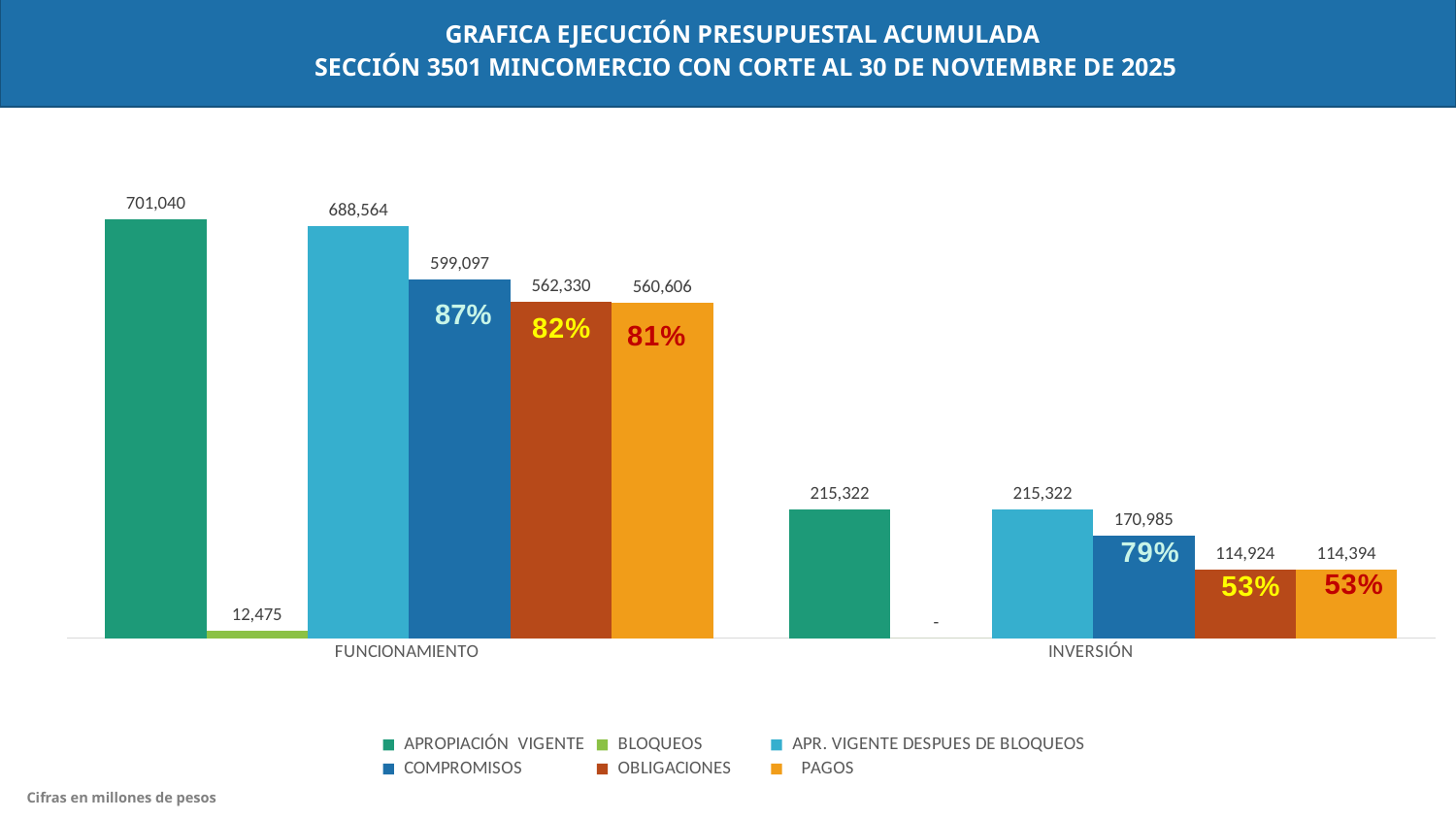
Which series has the highest value for FUNCIONAMIENTO? APROPIACIÓN VIGENTE What percentage is shown on the OBLIGACIONES bar for INVERSIÓN? 53% What is the difference between APROPIACIÓN VIGENTE and APR. VIGENTE DESPUES DE BLOQUEOS for FUNCIONAMIENTO? 12,476 What is the value of COMPROMISOS for INVERSIÓN? 170,985 Which series has the lowest value for FUNCIONAMIENTO? BLOQUEOS Which is larger for INVERSIÓN: OBLIGACIONES or PAGOS? OBLIGACIONES How many series does the legend list? 6 What is the value of APROPIACIÓN VIGENTE for FUNCIONAMIENTO? 701,040 What is the value of PAGOS for FUNCIONAMIENTO? 560,606 What kind of chart is shown on the slide? Bar chart What is the value of BLOQUEOS for FUNCIONAMIENTO? 12,475 How many categories are shown on the x axis? 2